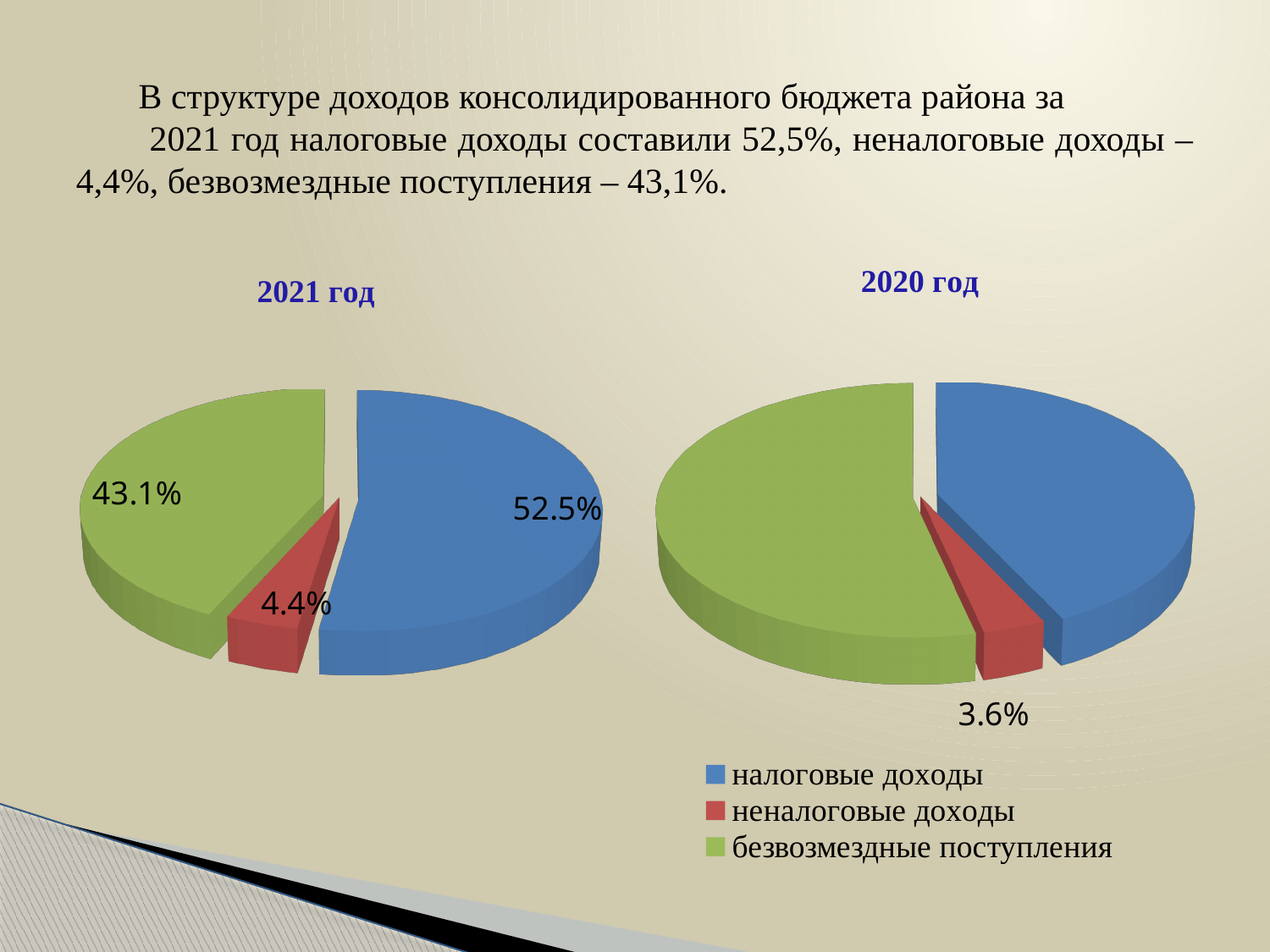
In the 2021 год chart, which category has the smallest share? неналоговые доходы In the 2021 год chart, what is the difference between the shares of налоговые доходы and безвозмездные поступления? 9.4% In the 2021 год chart, what share do неналоговые доходы have? 4.4% In the 2021 год chart, what share do безвозмездные поступления have? 43.1% In the 2020 год chart, which category has the smallest share? неналоговые доходы How many categories does the legend list? 3 In the 2020 год chart, what share do неналоговые доходы have? 3.6% Which colour represents безвозмездные поступления in the charts? Green What kind of charts are shown on the slide? Pie charts In the 2021 год chart, which category has the largest share? налоговые доходы In the 2021 год chart, which is larger: налоговые доходы or безвозмездные поступления? налоговые доходы In the 2021 год chart, what share do налоговые доходы have? 52.5%